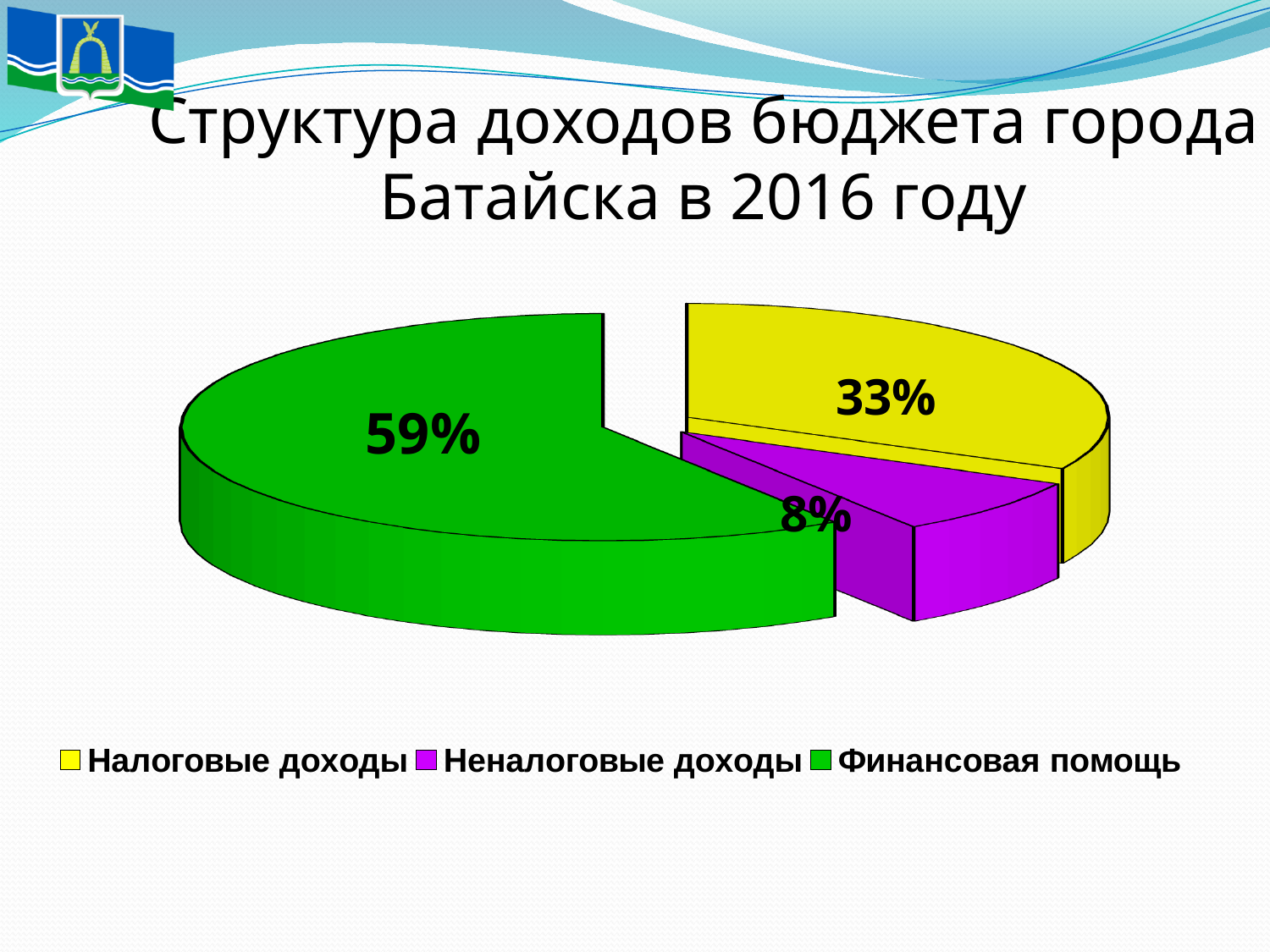
What share of the pie does Неналоговые доходы have? 8% What is the difference in percentage points between Налоговые доходы and Неналоговые доходы? 25 Which is larger, Налоговые доходы or Неналоговые доходы? Налоговые доходы What is the title of the slide? Структура доходов бюджета города Батайска в 2016 году What colour is the slice for Неналоговые доходы? Purple What kind of chart is shown on the slide? Pie chart What share of the pie does Налоговые доходы have? 33% How many categories are shown in the pie chart? 3 Which category has the largest slice of the pie? Финансовая помощь Which category has the smallest slice of the pie? Неналоговые доходы What is the difference in percentage points between Финансовая помощь and Налоговые доходы? 26 What share of the pie does Финансовая помощь have? 59%